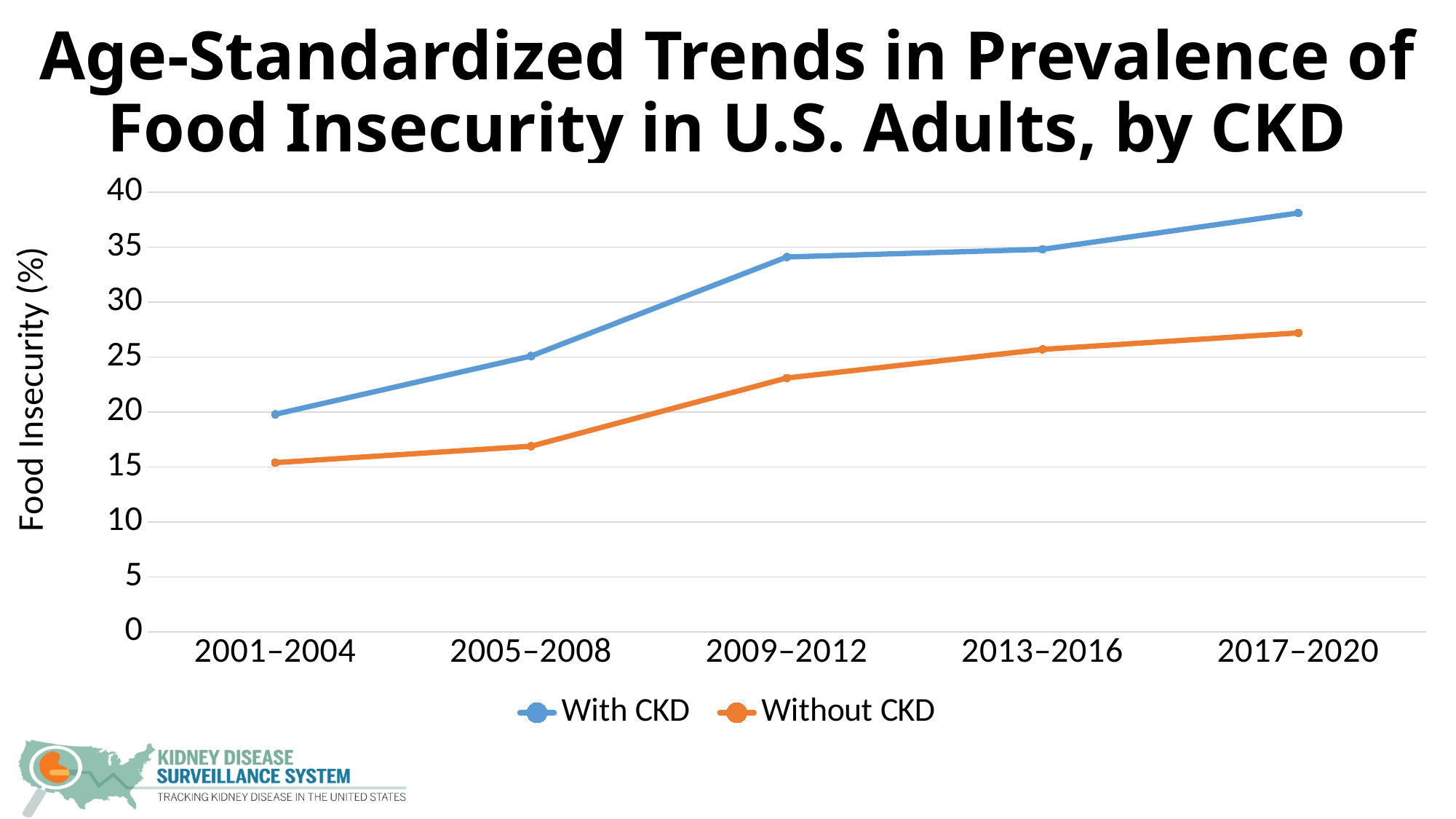
What is the label on the y axis? Food Insecurity (%) In which period is the With CKD value highest? 2017–2020 In 2009–2012, which series has the larger value, With CKD or Without CKD? With CKD Do the values for With CKD rise or fall from 2001–2004 to 2017–2020? rise Is the value for Without CKD in 2001–2004 greater or less than 20? less Is the value for Without CKD in 2017–2020 greater or less than 25? greater How many time periods are shown on the x axis? 5 Is the value for With CKD in 2017–2020 greater or less than 35? greater In which period is the Without CKD value lowest? 2001–2004 How many series does the legend list? 2 What kind of chart is shown on the slide? line chart